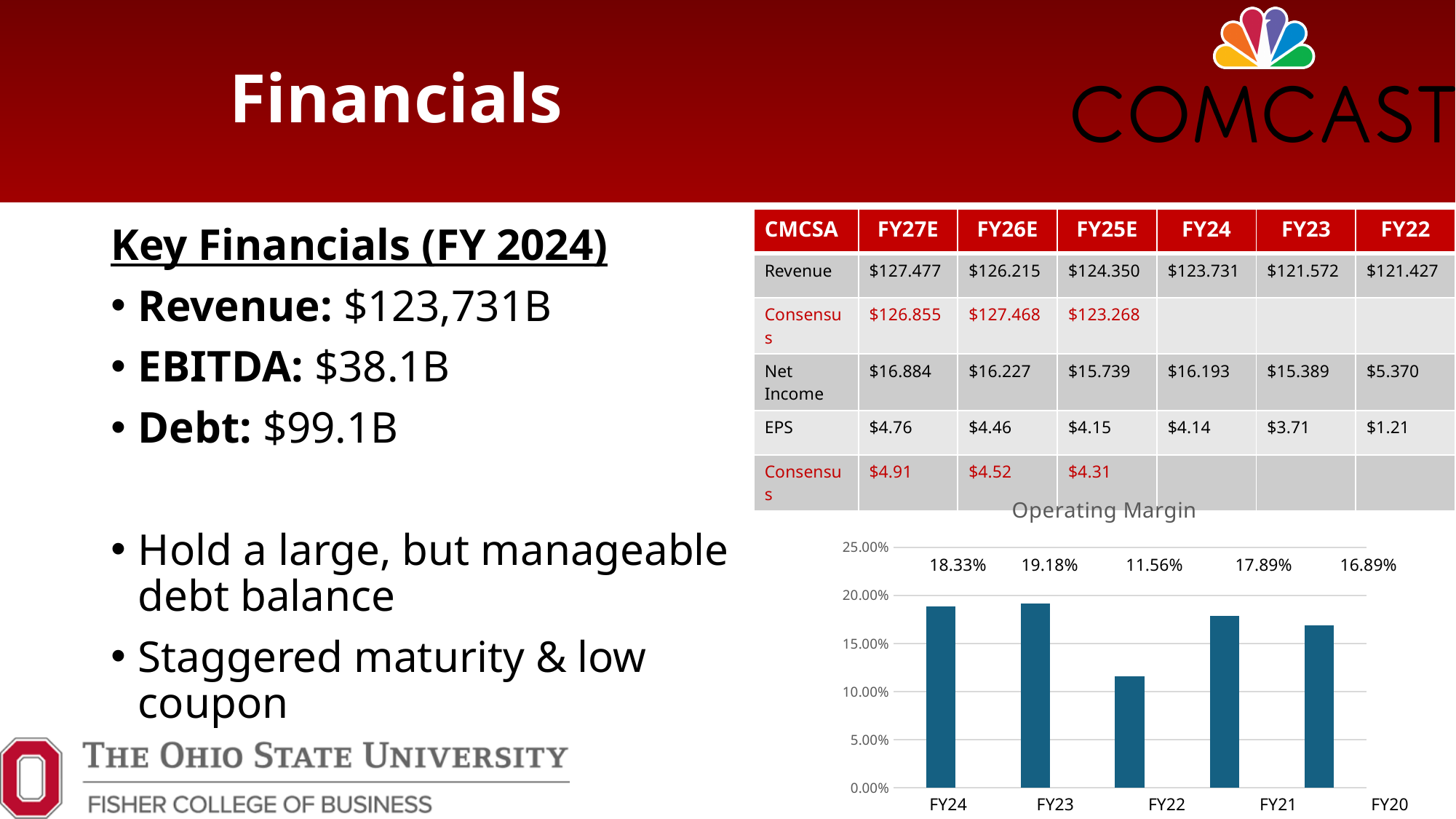
What is the title of the chart on the slide? Operating Margin In the Operating Margin chart, which fiscal year has the lowest operating margin? FY22 In the Operating Margin chart, which fiscal year has the highest operating margin? FY23 In the Operating Margin chart, what is the value for FY24? 18.33% In the Operating Margin chart, what is the difference between the FY24 and FY21 values? 0.44% How many fiscal years are shown in the Operating Margin chart? 5 In the Operating Margin chart, what is the value for FY20? 16.89% In the Operating Margin chart, which is larger, the value for FY21 or the value for FY20? FY21 In the Operating Margin chart, what is the value for FY22? 11.56% In the Operating Margin chart, what is the difference between the FY23 and FY22 values? 7.62% What type of chart is the Operating Margin chart? bar chart In the Operating Margin chart, is the value for FY22 greater or less than 15.00%? less